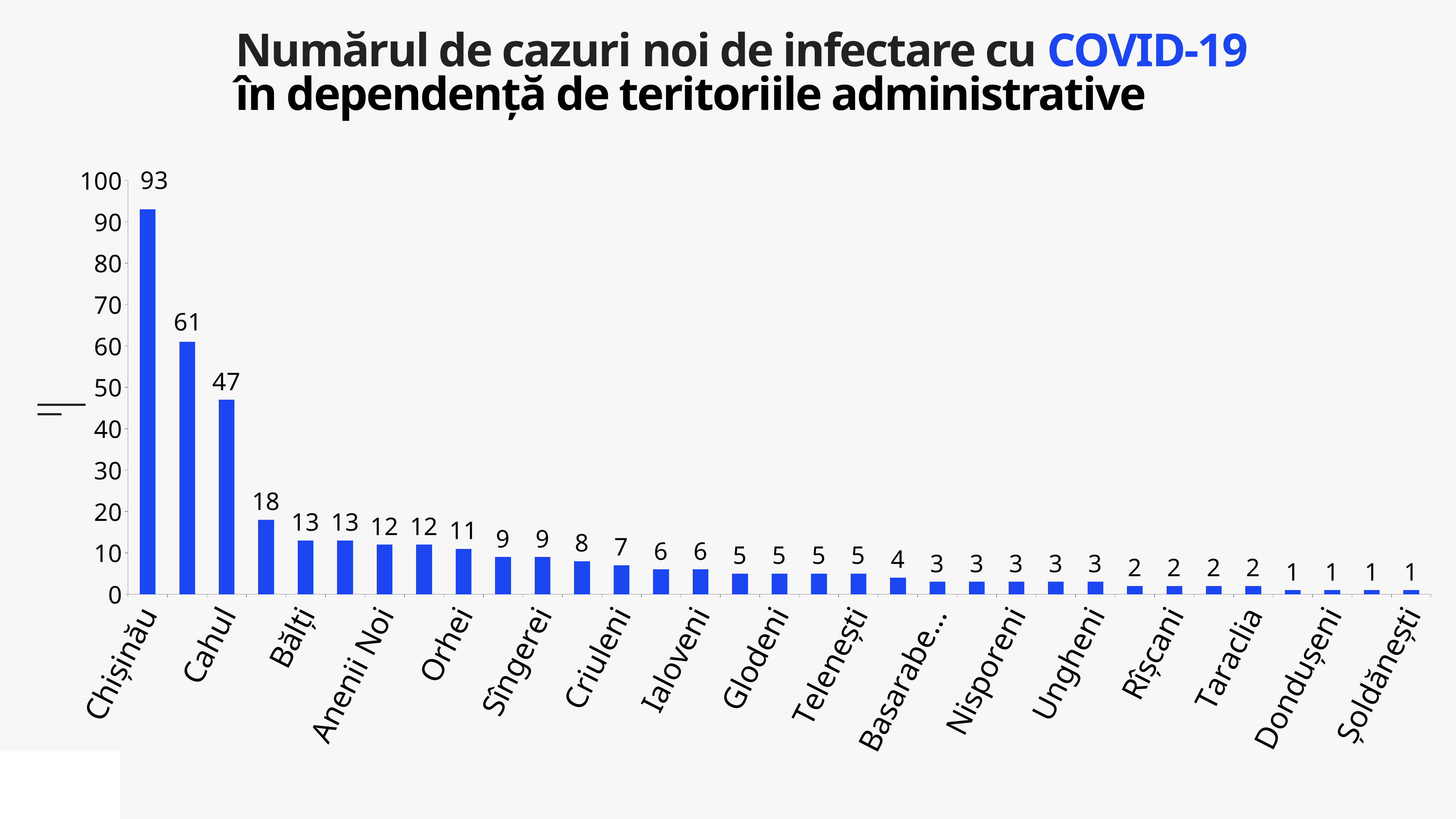
Which territory has the highest number of new cases? Chișinău Do the values rise or fall from left to right along the x axis? fall What is the number of new COVID-19 cases for Anenii Noi? 12 What is the number of new COVID-19 cases for Chișinău? 93 What is the difference between the values for Chișinău and Cahul? 46 Is the value for Chișinău greater or less than 90? greater How many bars are plotted in the chart? 33 Which has more new cases, Chișinău or Cahul? Chișinău What is the number of new COVID-19 cases for Orhei? 11 What is the highest value shown on the vertical axis? 100 What is the number of new COVID-19 cases for Cahul? 47 What type of chart is shown on the slide? bar chart